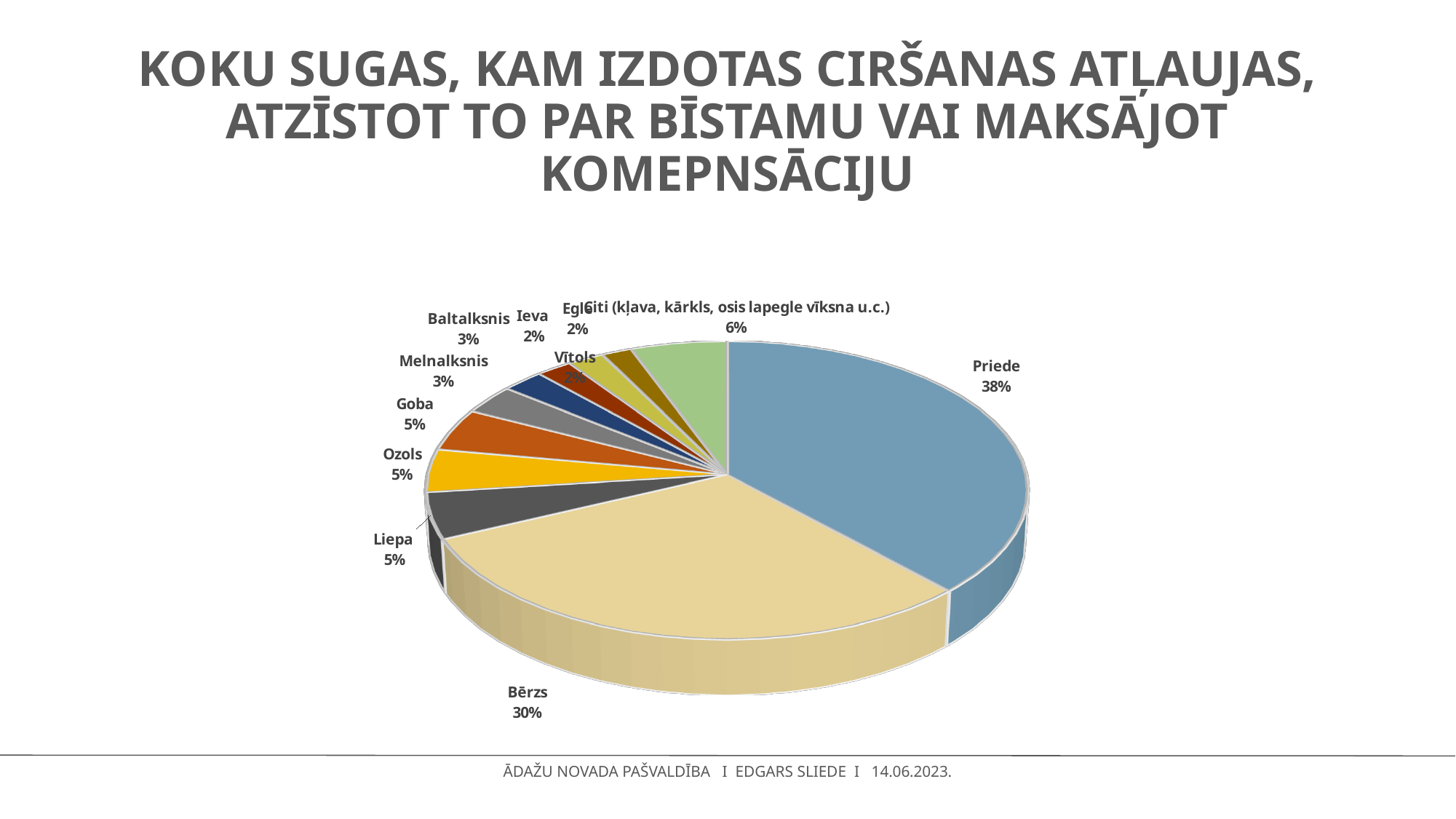
What share of the pie does Ieva have? 2% What share of the pie does Priede have? 38% What share of the pie does Bērzs have? 30% By how many percentage points does Priede's share exceed Bērzs's share? 8 percentage points What share of the pie does Melnalksnis have? 3% Which has a larger share, Ozols or Baltalksnis? Ozols How many slices does the pie chart have? 11 What kind of chart is shown on the slide? pie chart What share of the pie does Goba have? 5% Which tree species has the largest share of the pie? Priede What is the combined share of Priede and Bērzs? 68% What share of the pie does the 'Citi (kļava, kārkls, osis lapegle vīksna u.c.)' slice have? 6%